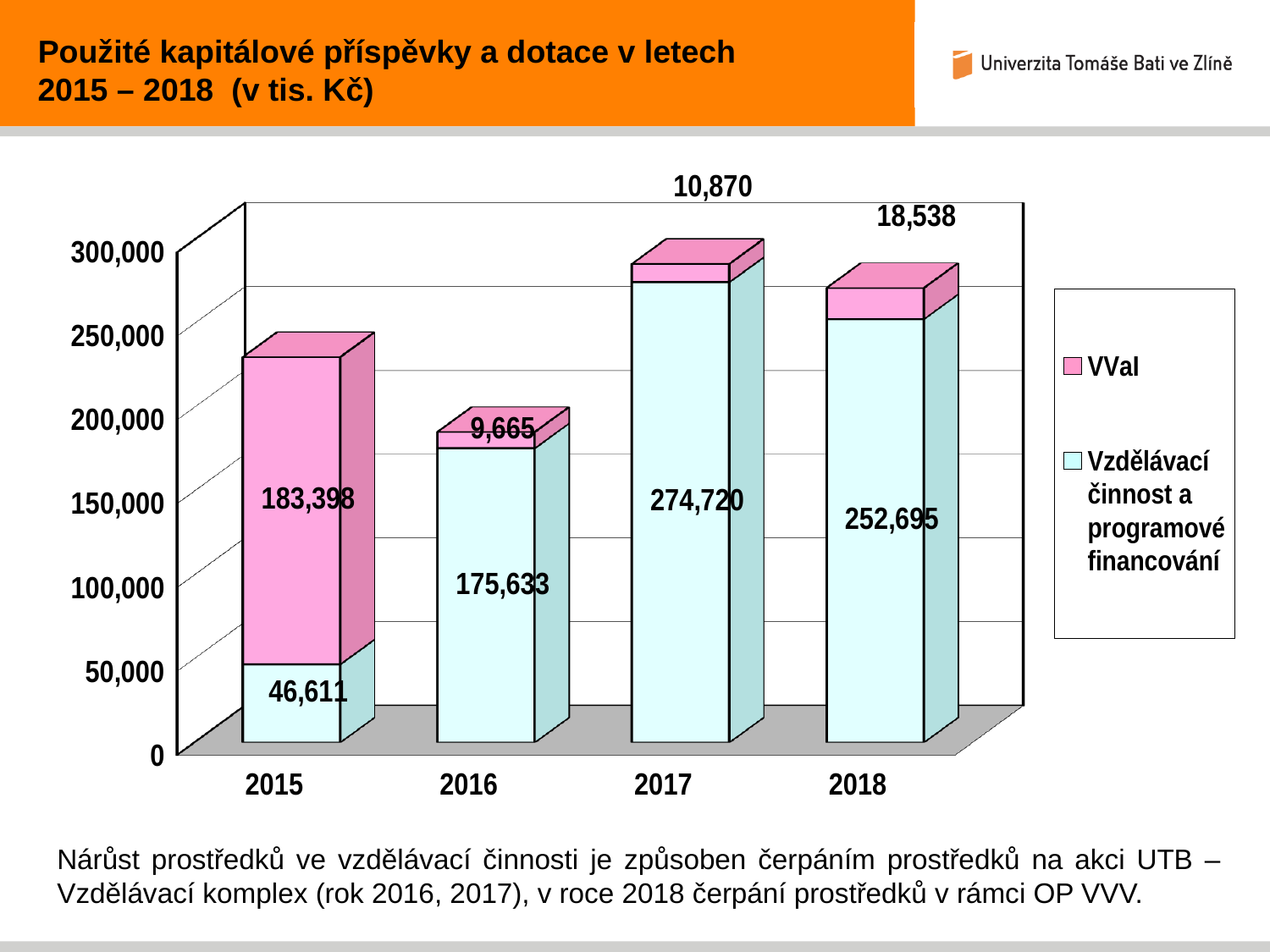
What is the value for VVaI in 2018? 18,538 How many years are shown on the x axis? 4 How many series does the legend list? 2 What is the value for VVaI in 2015? 183,398 What is the value for Vzdělávací činnost a programové financování in 2017? 274,720 What kind of chart is shown on the slide? Stacked bar chart What is the value for Vzdělávací činnost a programové financování in 2015? 46,611 Which year has the highest value for Vzdělávací činnost a programové financování? 2017 What is the total of the stacked bar for 2015? 230,009 Which year has the lowest value for VVaI? 2016 Which is larger: the VVaI value in 2016 or in 2017? 2017 What is the difference between the Vzdělávací činnost a programové financování values for 2017 and 2018? 22,025